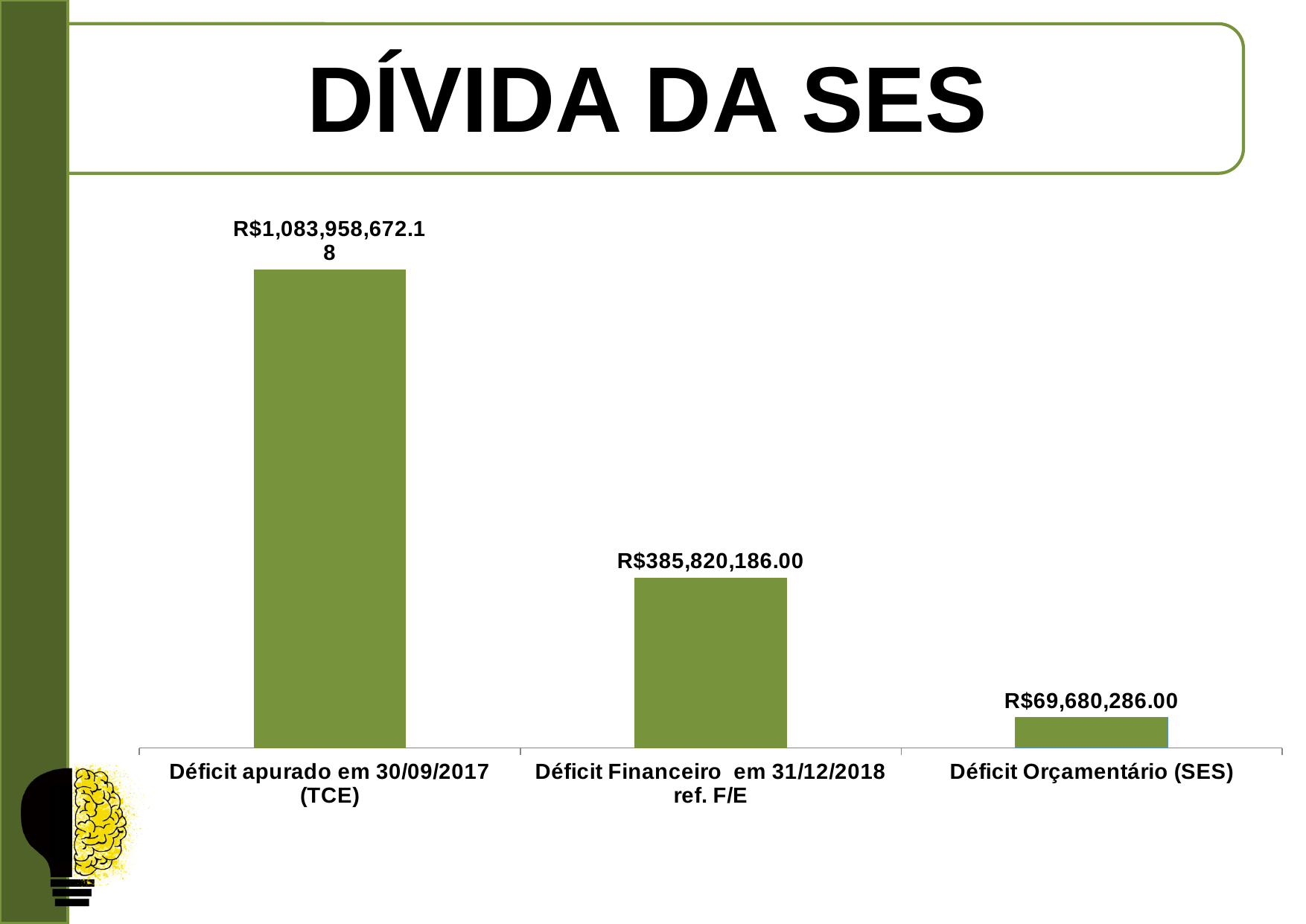
How many categories are shown in the chart? 3 What is the difference between Déficit Financeiro em 31/12/2018 ref. F/E and Déficit Orçamentário (SES)? R$316,139,900.00 What is the value for Déficit Financeiro em 31/12/2018 ref. F/E? R$385,820,186.00 Which is larger, Déficit Financeiro em 31/12/2018 ref. F/E or Déficit Orçamentário (SES)? Déficit Financeiro em 31/12/2018 ref. F/E Which category has the highest value? Déficit apurado em 30/09/2017 (TCE) Do the values rise or fall from left to right across the categories? Fall What is the title shown at the top of the slide? DÍVIDA DA SES What is the difference between Déficit apurado em 30/09/2017 (TCE) and Déficit Financeiro em 31/12/2018 ref. F/E? R$698,138,486.18 What is the value for Déficit apurado em 30/09/2017 (TCE)? R$1,083,958,672.18 What kind of chart is shown on the slide? Bar chart What is the value for Déficit Orçamentário (SES)? R$69,680,286.00 Which category has the lowest value? Déficit Orçamentário (SES)